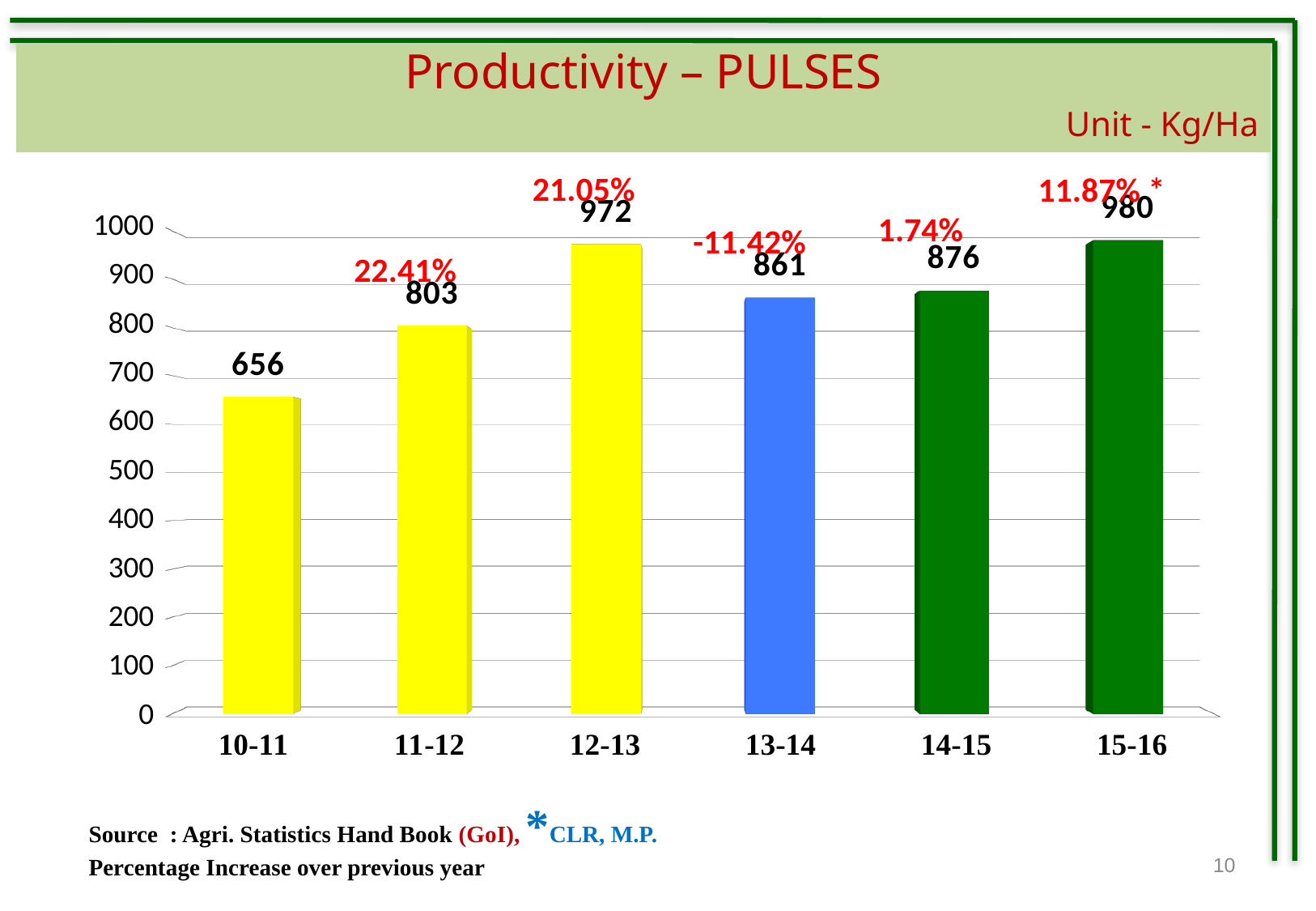
What is the productivity value for 15-16? 980 How many years are shown on the x axis? 6 What kind of chart is shown on the slide? bar chart What is the productivity value for 13-14? 861 What is the productivity value for 10-11? 656 What unit is given for the productivity values? Kg/Ha Which is larger, the productivity for 12-13 or for 13-14? 12-13 Which year has the highest productivity? 15-16 Is the value for 14-15 greater or less than 900? less What is the difference between the productivity values for 12-13 and 11-12? 169 What percentage increase over the previous year is shown for 11-12? 22.41% Which year has the lowest productivity? 10-11